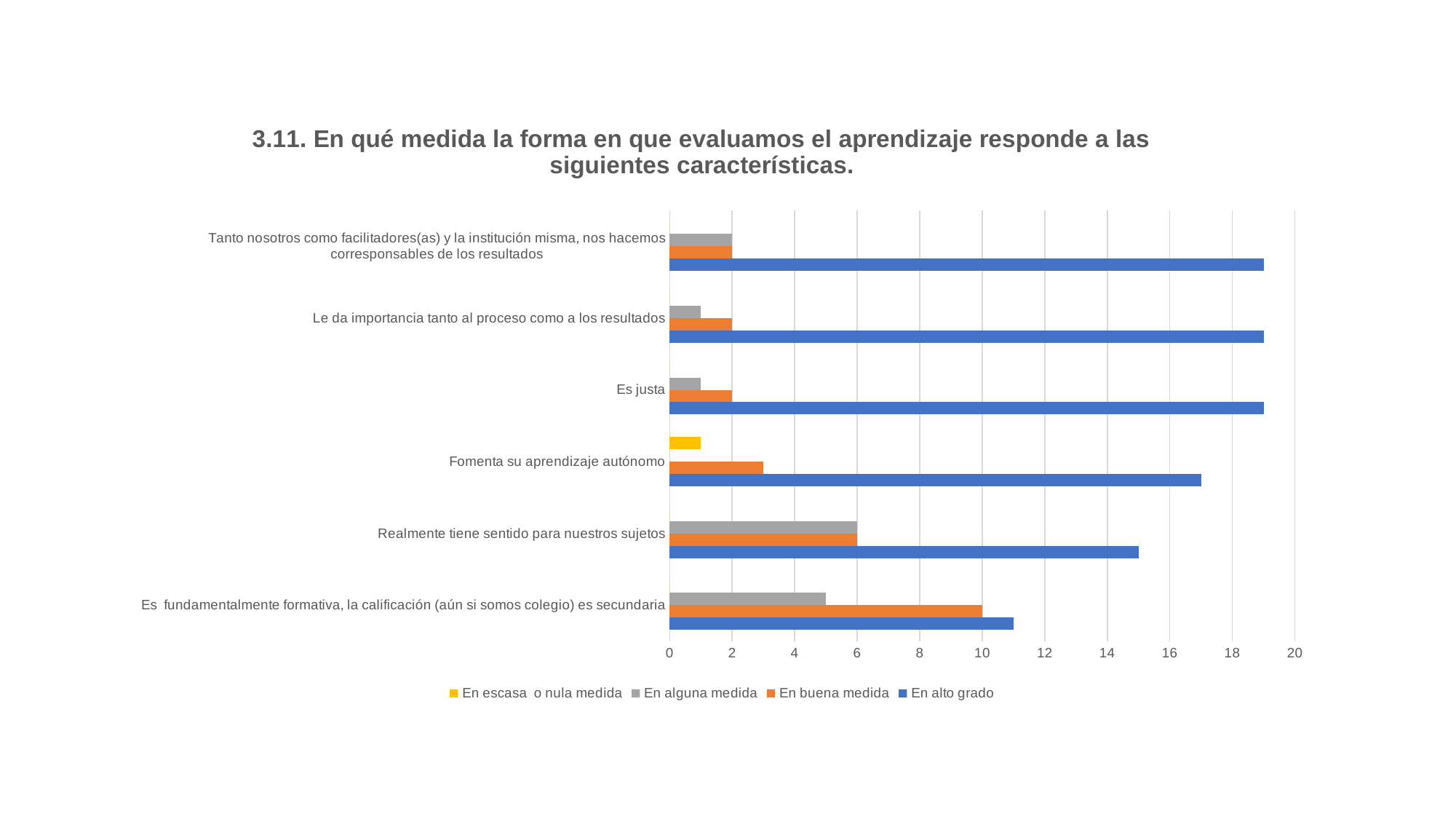
What is the value of 'En buena medida' for 'Es fundamentalmente formativa, la calificación (aún si somos colegio) es secundaria'? 10 How many series does the legend list? 4 What is the value of 'En alguna medida' for 'Realmente tiene sentido para nuestros sujetos'? 6 Which category has the lowest 'En alto grado' value? Es fundamentalmente formativa, la calificación (aún si somos colegio) es secundaria Which is larger for 'Fomenta su aprendizaje autónomo': 'En alto grado' or 'En buena medida'? En alto grado What is the value of 'En buena medida' for 'Le da importancia tanto al proceso como a los resultados'? 2 Which series is shown in yellow in the legend? En escasa o nula medida What kind of chart is shown on the slide? bar chart How many categories are plotted on the chart? 6 Is the value of 'En alto grado' for 'Es justa' greater or less than 18? greater Which category has the highest 'En buena medida' value? Es fundamentalmente formativa, la calificación (aún si somos colegio) es secundaria Is the value of 'En alto grado' for 'Es fundamentalmente formativa, la calificación (aún si somos colegio) es secundaria' greater or less than 12? less